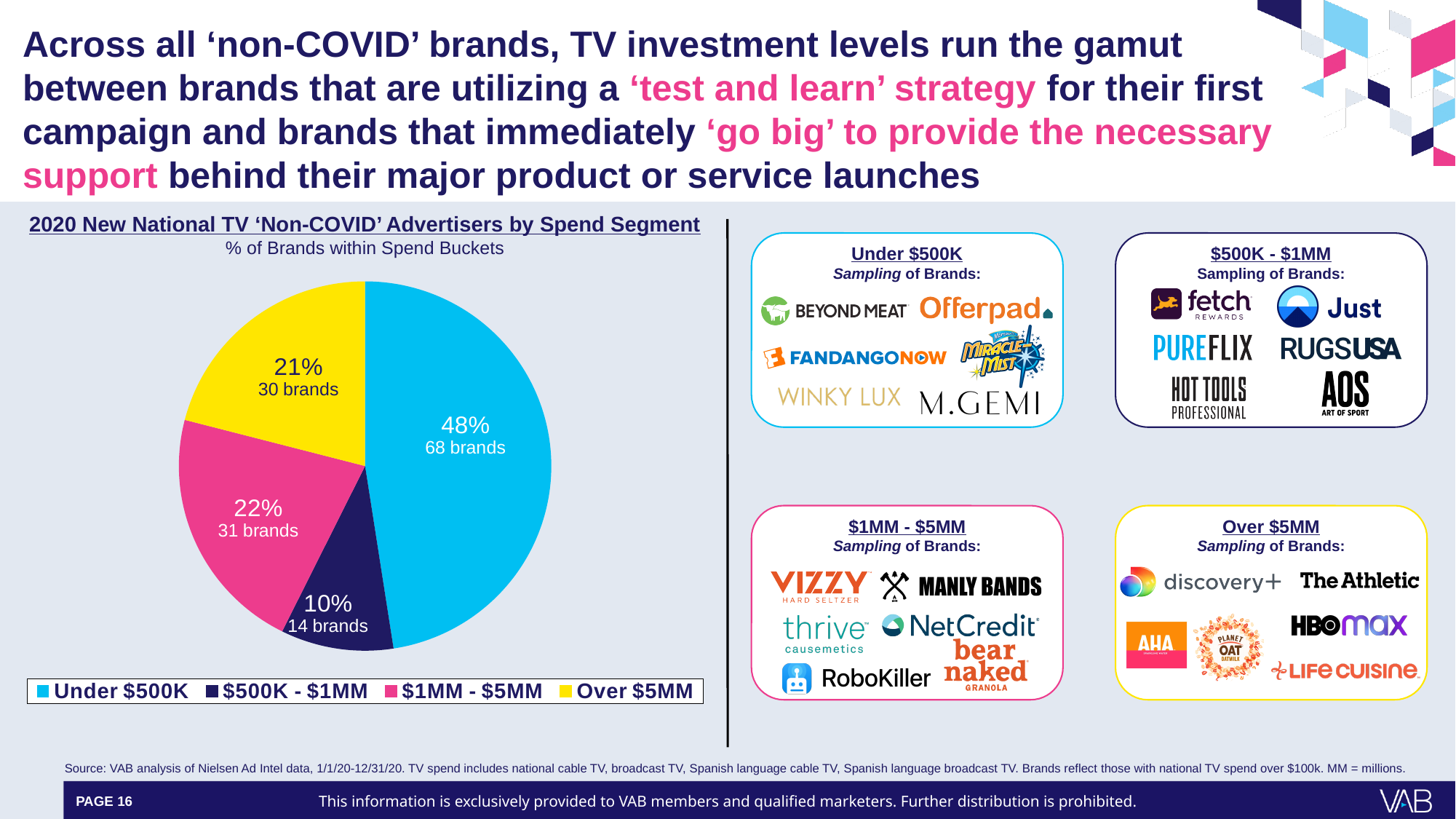
What is the title of the pie chart? 2020 New National TV 'Non-COVID' Advertisers by Spend Segment Which segment has more brands, $1MM - $5MM or $500K - $1MM? $1MM - $5MM Which spend segment has the largest share of brands? Under $500K What colour represents the Over $5MM segment in the pie chart? Yellow How many brands are in the $500K - $1MM spend segment? 14 brands What is the difference in number of brands between the Under $500K segment and the $500K - $1MM segment? 54 brands What type of chart is shown on the slide? Pie chart How many brands are in the Over $5MM spend segment? 30 brands What percentage of brands fall in the Under $500K spend segment? 48% How many spend segments are shown in the pie chart? 4 What percentage of brands fall in the $1MM - $5MM spend segment? 22% Which spend segment has the smallest share of brands? $500K - $1MM